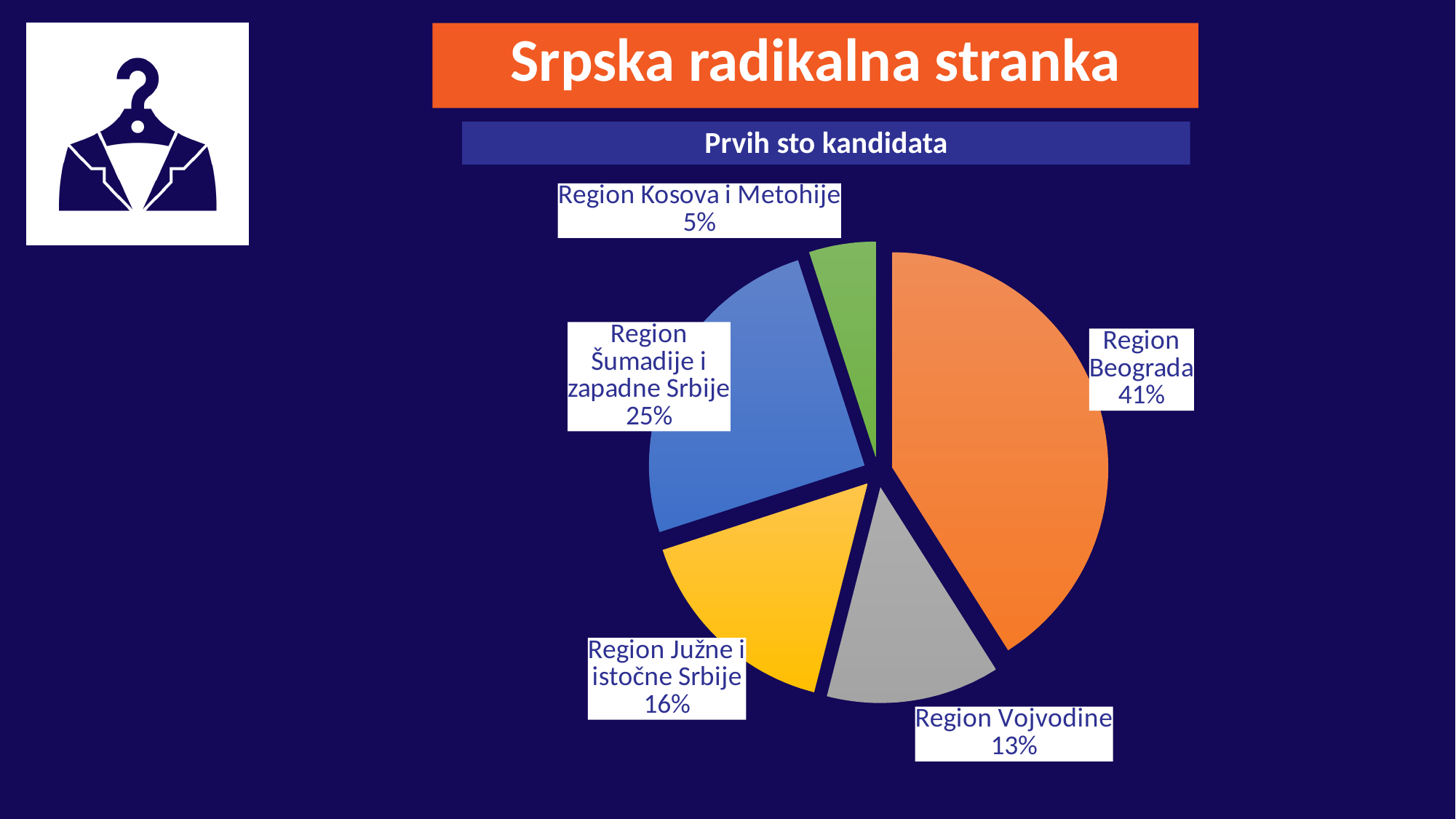
What share of the pie does Region Beograda have? 41% Which region has the smallest slice of the pie? Region Kosova i Metohije What is the value shown for Region Južne i istočne Srbije? 16% What is the value shown for Region Vojvodine? 13% How many regions are shown in the pie chart? 5 Which region has the largest slice of the pie? Region Beograda Which is larger, the share for Region Vojvodine or the share for Region Južne i istočne Srbije? Region Južne i istočne Srbije What is the difference in percentage points between Region Beograda and Region Šumadije i zapadne Srbije? 16 What is the value shown for Region Kosova i Metohije? 5% What is the value shown for Region Šumadije i zapadne Srbije? 25% What kind of chart is shown on the slide? Pie chart What is the subtitle shown above the chart? Prvih sto kandidata